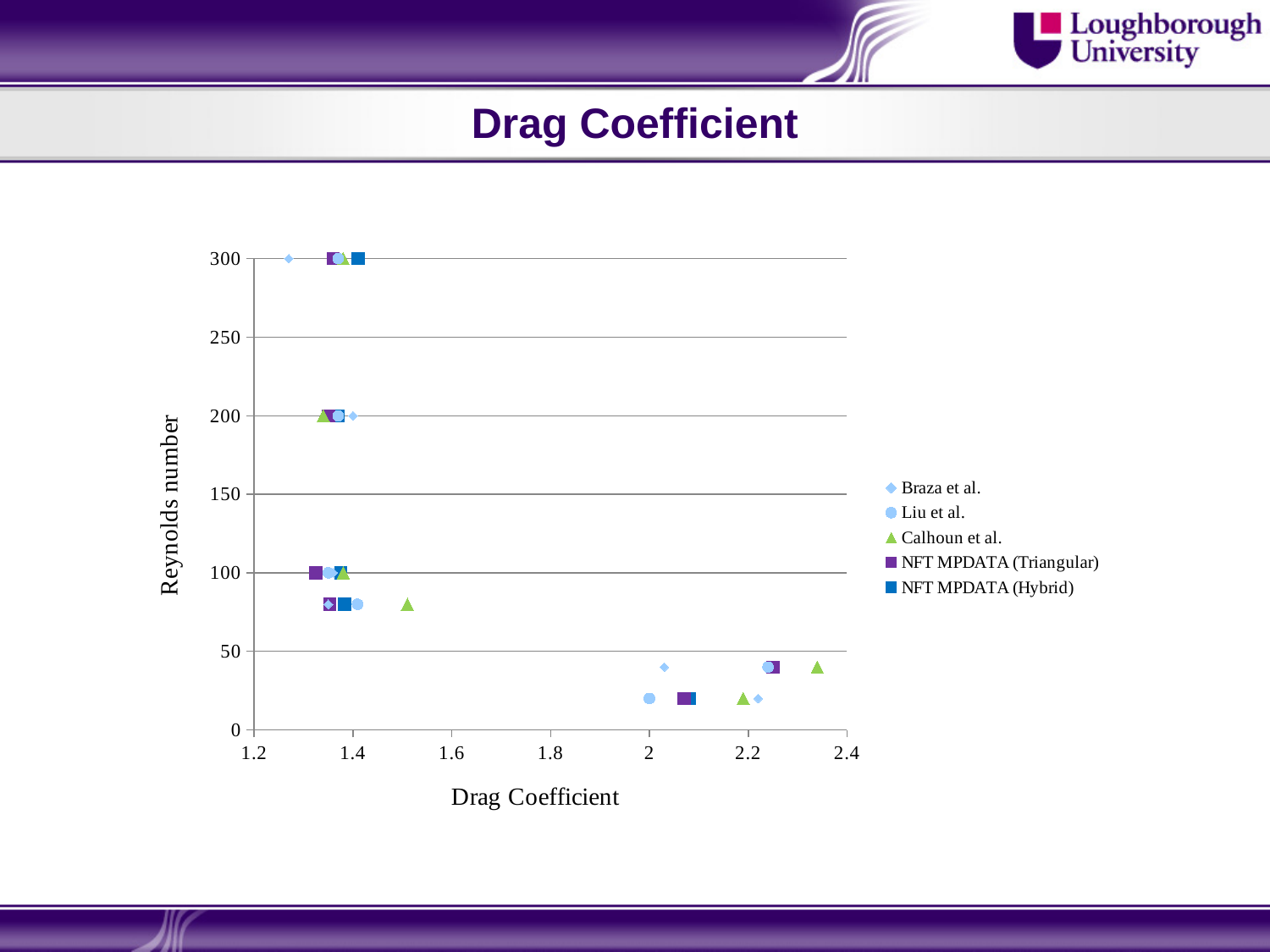
What is the title of the horizontal axis? Drag Coefficient At Reynolds number 300, which series has the larger drag coefficient, Braza et al. or NFT MPDATA (Hybrid)? NFT MPDATA (Hybrid) What kind of chart is shown on the slide? Scatter chart At Reynolds number 300, is the drag coefficient for Braza et al. greater or less than 1.4? less For the points plotted below Reynolds number 50, are the drag coefficient values greater or less than 1.8? greater What is the title of the vertical axis? Reynolds number Which series has the single lowest drag coefficient value plotted on the chart? Braza et al. At Reynolds number 200, is the drag coefficient for Calhoun et al. greater or less than 1.6? less As the Reynolds number increases, do the plotted drag coefficient values generally increase or decrease? decrease Which series has the single highest drag coefficient value plotted on the chart? Calhoun et al. How many series does the legend list? 5